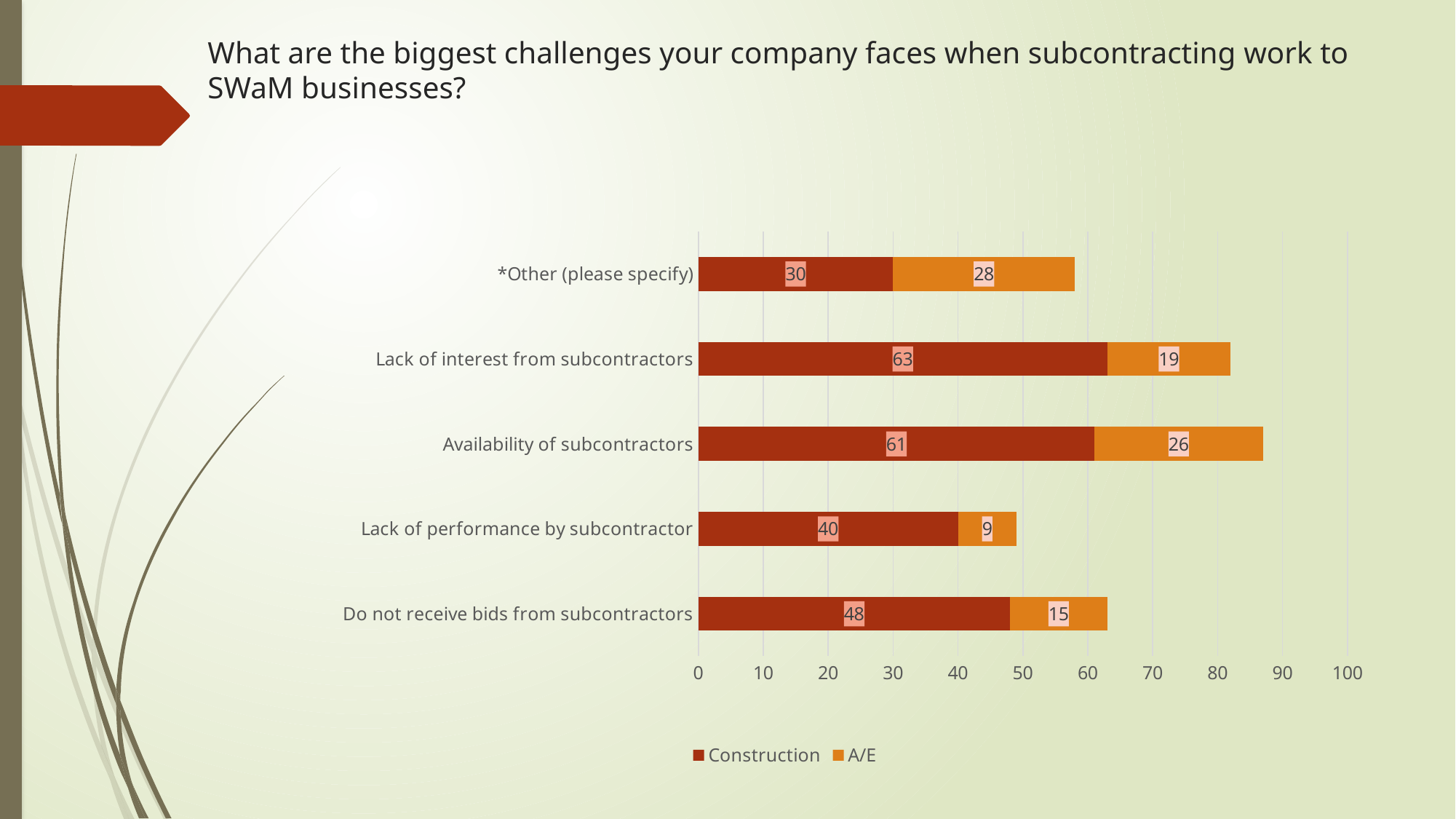
What is the total of the stacked bar for Availability of subcontractors? 87 What is the A/E value for Availability of subcontractors? 26 How many categories are shown on the chart? 5 How many series does the legend list? 2 What is the total of the stacked bar for Do not receive bids from subcontractors? 63 What is the A/E value for Lack of performance by subcontractor? 9 What kind of chart is shown on the slide? Stacked bar chart Which category has the highest Construction value? Lack of interest from subcontractors Which category has the lowest A/E value? Lack of performance by subcontractor Which is larger: the A/E value for *Other (please specify) or the A/E value for Lack of interest from subcontractors? *Other (please specify) What is the difference between the Construction values for Availability of subcontractors and Do not receive bids from subcontractors? 13 What is the Construction value for Lack of interest from subcontractors? 63